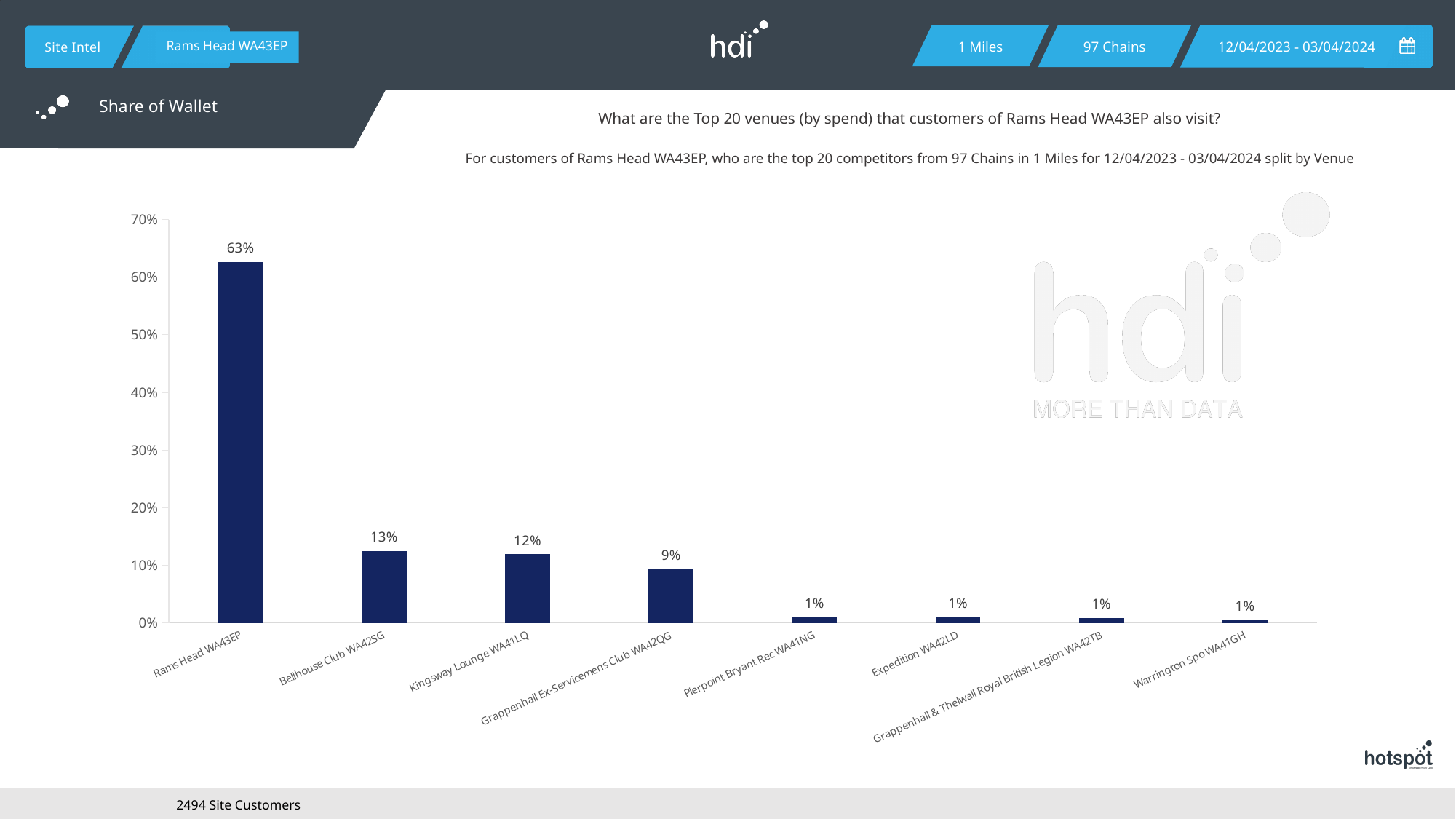
What is the value for Grappenhall Ex-Servicemens Club WA42QG? 9% Is the value for Rams Head WA43EP greater or less than 50%? greater How many venues are shown on the chart? 8 What is the difference between the values for Rams Head WA43EP and Bellhouse Club WA42SG? 50% What is the value for Pierpoint Bryant Rec WA41NG? 1% What is the value for Kingsway Lounge WA41LQ? 12% Which venue has the highest value? Rams Head WA43EP What is the difference between the values for Kingsway Lounge WA41LQ and Grappenhall Ex-Servicemens Club WA42QG? 3% What is the value for Rams Head WA43EP? 63% What kind of chart is shown on the slide? bar chart What is the value for Bellhouse Club WA42SG? 13% Which is larger, the value for Bellhouse Club WA42SG or the value for Grappenhall Ex-Servicemens Club WA42QG? Bellhouse Club WA42SG